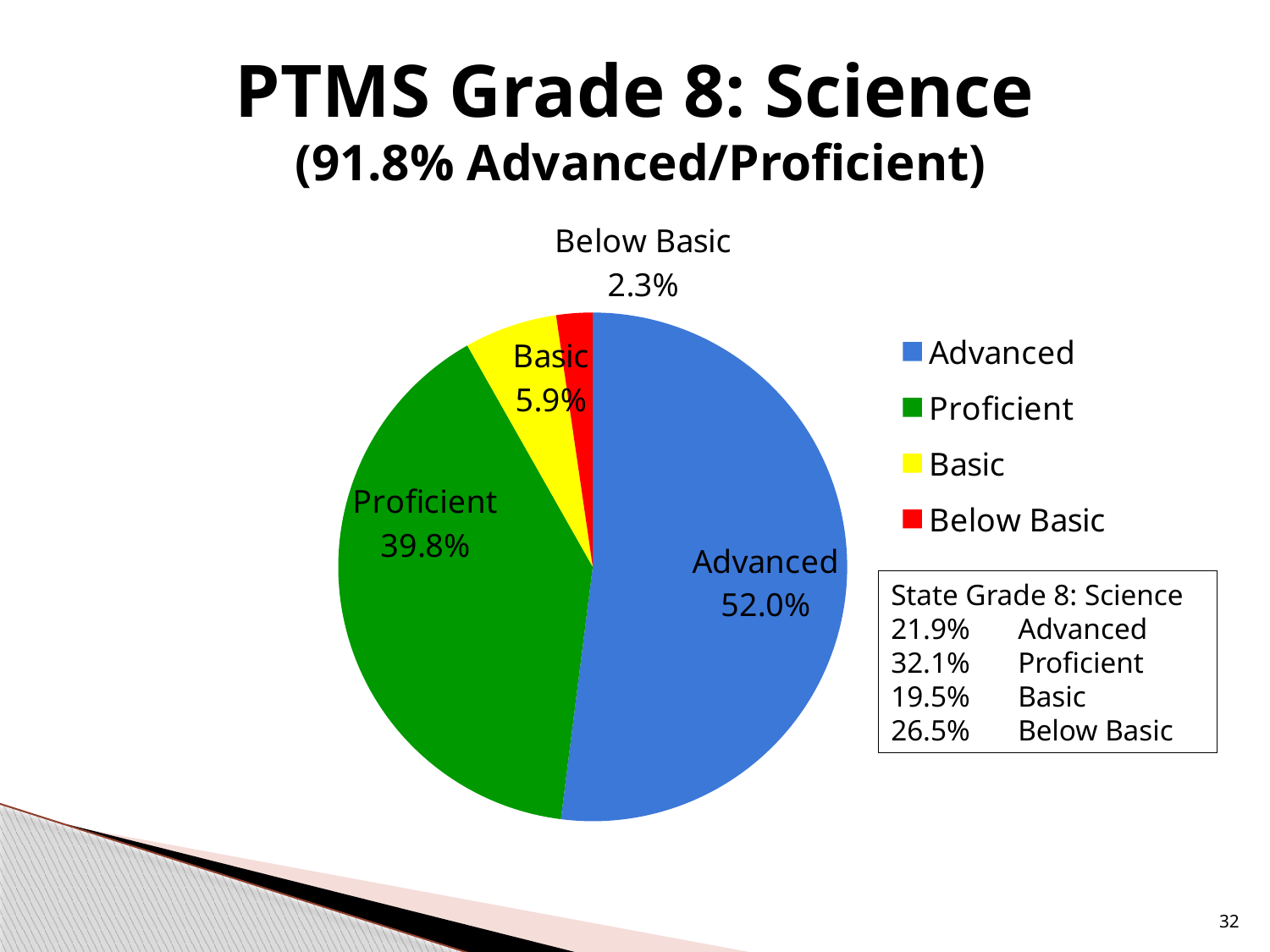
What share of the pie is labelled Proficient? 39.8% How many categories does the pie chart show? 4 Which slice is larger, Basic or Below Basic? Basic What is the combined share of the Advanced and Proficient slices? 91.8% What colour is the Proficient slice? green What is the difference in percentage points between the Advanced and Proficient slices? 12.2 What share of the pie is labelled Basic? 5.9% Which category has the largest slice of the pie? Advanced What share of the pie is labelled Below Basic? 2.3% What share of the pie is labelled Advanced? 52.0% What kind of chart is shown on the slide? pie chart Which category has the smallest slice of the pie? Below Basic